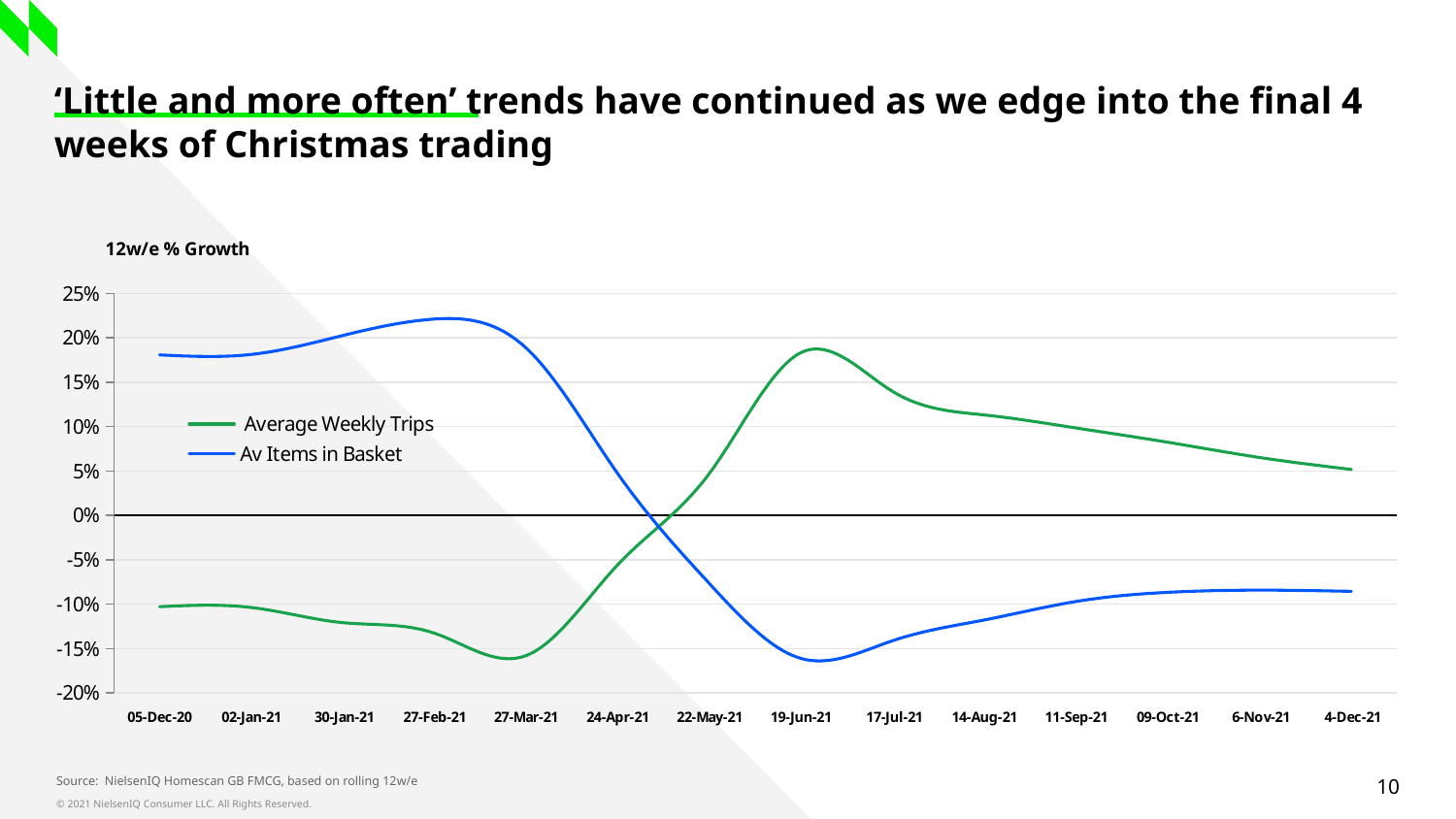
Is the value for Average Weekly Trips at 05-Dec-20 greater or less than -5%? less Does the Average Weekly Trips line rise or fall between 19-Jun-21 and 4-Dec-21? Fall At 05-Dec-20, which series has the higher value, Average Weekly Trips or Av Items in Basket? Av Items in Basket How many series does the chart's legend list? 2 Is the value for Average Weekly Trips at 4-Dec-21 greater or less than 0%? greater Is the value for Av Items in Basket at 05-Dec-20 greater or less than 15%? greater How many dates are labelled along the x axis of the chart? 14 What kind of chart is shown on the slide? Line chart Which series is drawn in green in the chart? Average Weekly Trips What is the title shown above the chart? 12w/e % Growth At 4-Dec-21, which series has the higher value, Average Weekly Trips or Av Items in Basket? Average Weekly Trips